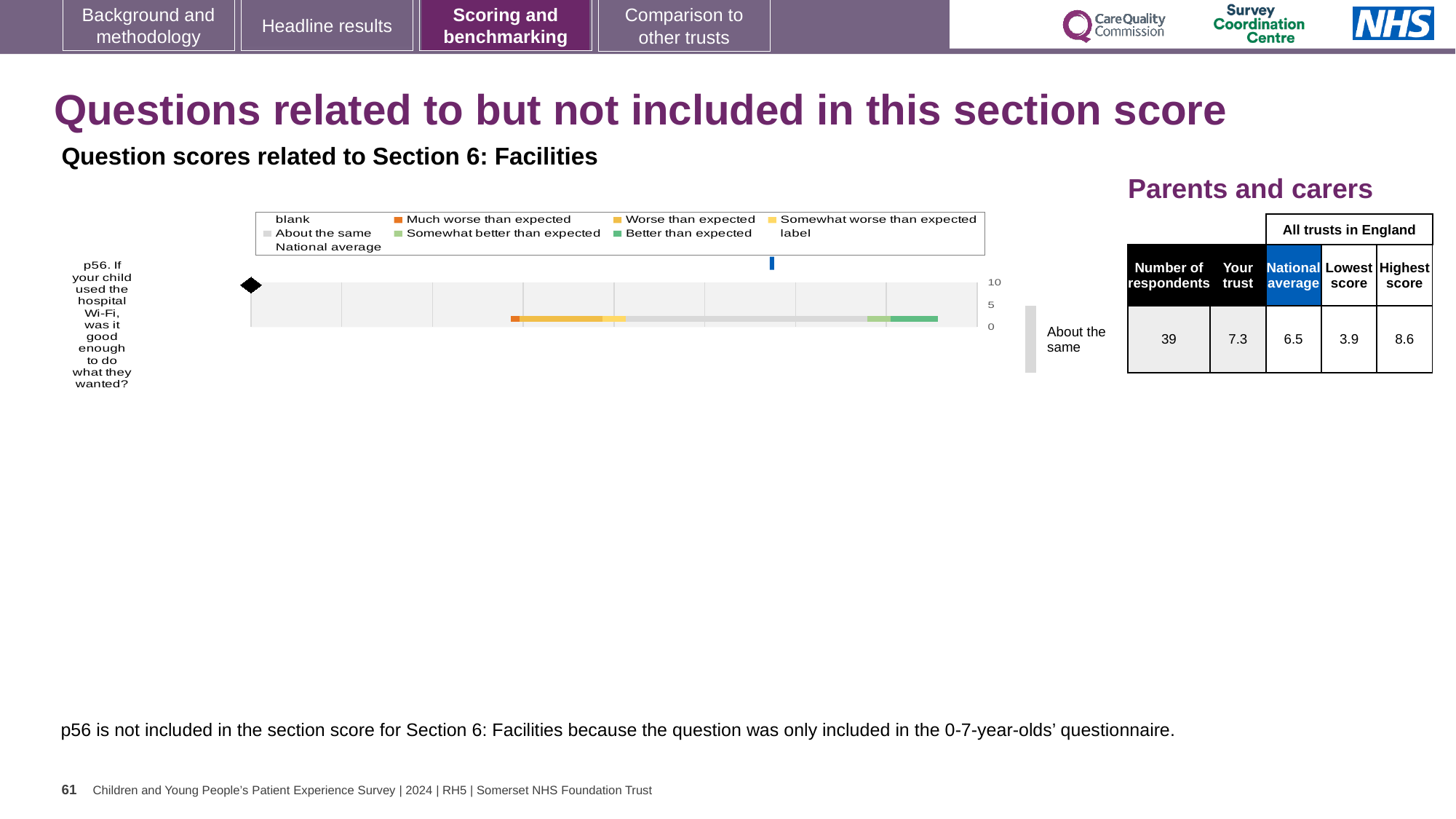
What kind of chart is used to show the p56 question score? bar chart How many respondents answered p56? 39 Which benchmark category is p56 assigned to on the slide? About the same What is the lowest score among all trusts in England for p56? 3.9 Is the trust's score for p56 higher or lower than the national average? higher What is the difference between the trust's score and the national average for p56? 0.8 What is the difference between the highest and lowest scores for p56? 4.7 What is the national average score for p56? 6.5 What is the 'Your trust' score for p56 in the table next to the chart? 7.3 What is the highest value shown on the chart's score axis? 10 How many questions are plotted in the chart? 1 What is the highest score among all trusts in England for p56? 8.6